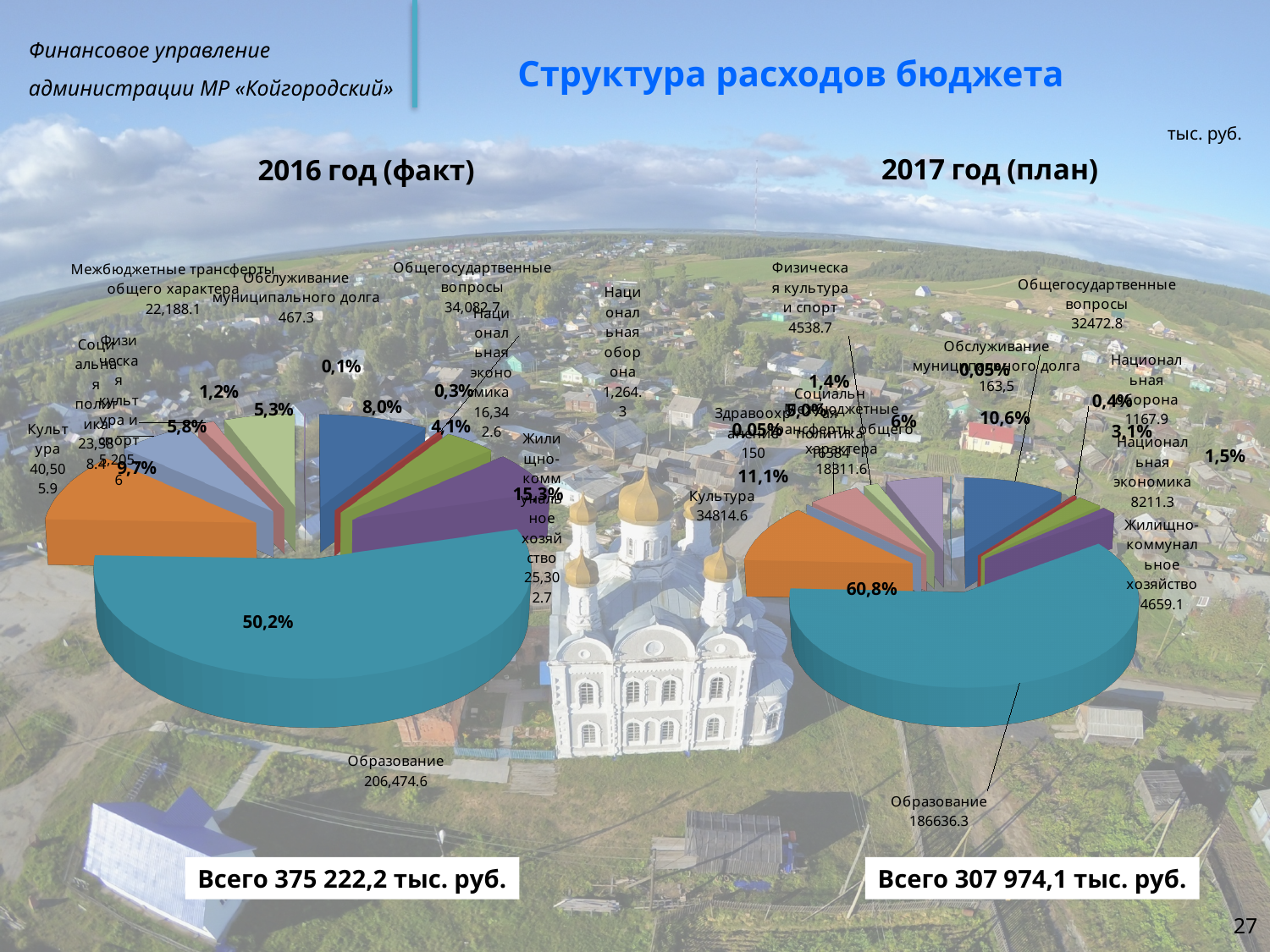
In the 2017 год (план) chart, what is the value for Образование? 186636.3 In the 2017 год (план) chart, which category has the largest share? Образование In the 2016 год (факт) chart, what is the value for Образование? 206,474.6 What total is shown below the 2016 год (факт) chart? Всего 375 222,2 тыс. руб. In the 2017 год (план) chart, what is the value for Общегосударственные вопросы? 32472.8 In the 2017 год (план) chart, what is the value for Жилищно-коммунальное хозяйство? 4659.1 In the 2017 год (план) chart, which category has the smallest value? Здравоохранение In the 2017 год (план) chart, what share of the pie does Образование take? 60,8% In the 2016 год (факт) chart, what is the value for Обслуживание муниципального долга? 467.3 Is the value for Образование larger in the 2016 год (факт) chart or in the 2017 год (план) chart? 2016 год (факт) What kind of chart is used for the 2016 год (факт) and 2017 год (план) budget structures? pie chart In the 2017 год (план) chart, what is the difference between Культура (34814.6) and Общегосударственные вопросы (32472.8)? 2341.8